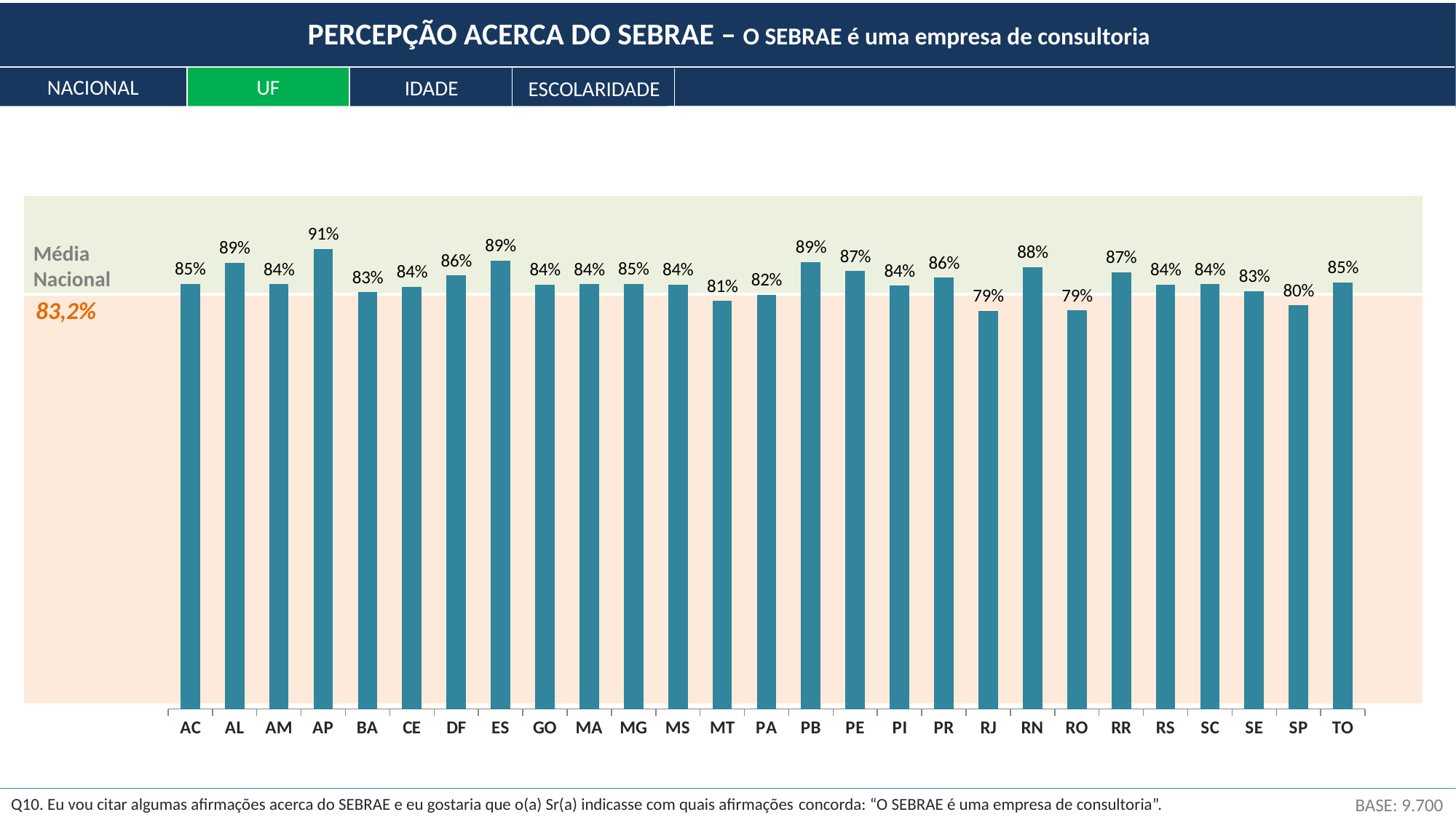
Which state has the highest value? AP What is the difference between the values for PB and PA? 7 percentage points What is the value for SP? 80% Which is larger, the value for RO or the value for RR? RR How many states (UFs) are shown on the x axis? 27 What is the value for RN? 88% What is the Média Nacional value shown on the chart? 83,2% Which is larger, the value for PE or the value for PI? PE What is the value for MT? 81% What is the difference between the values for AP and RJ? 12 percentage points What kind of chart is shown on the slide? Bar chart What is the value for AP? 91%